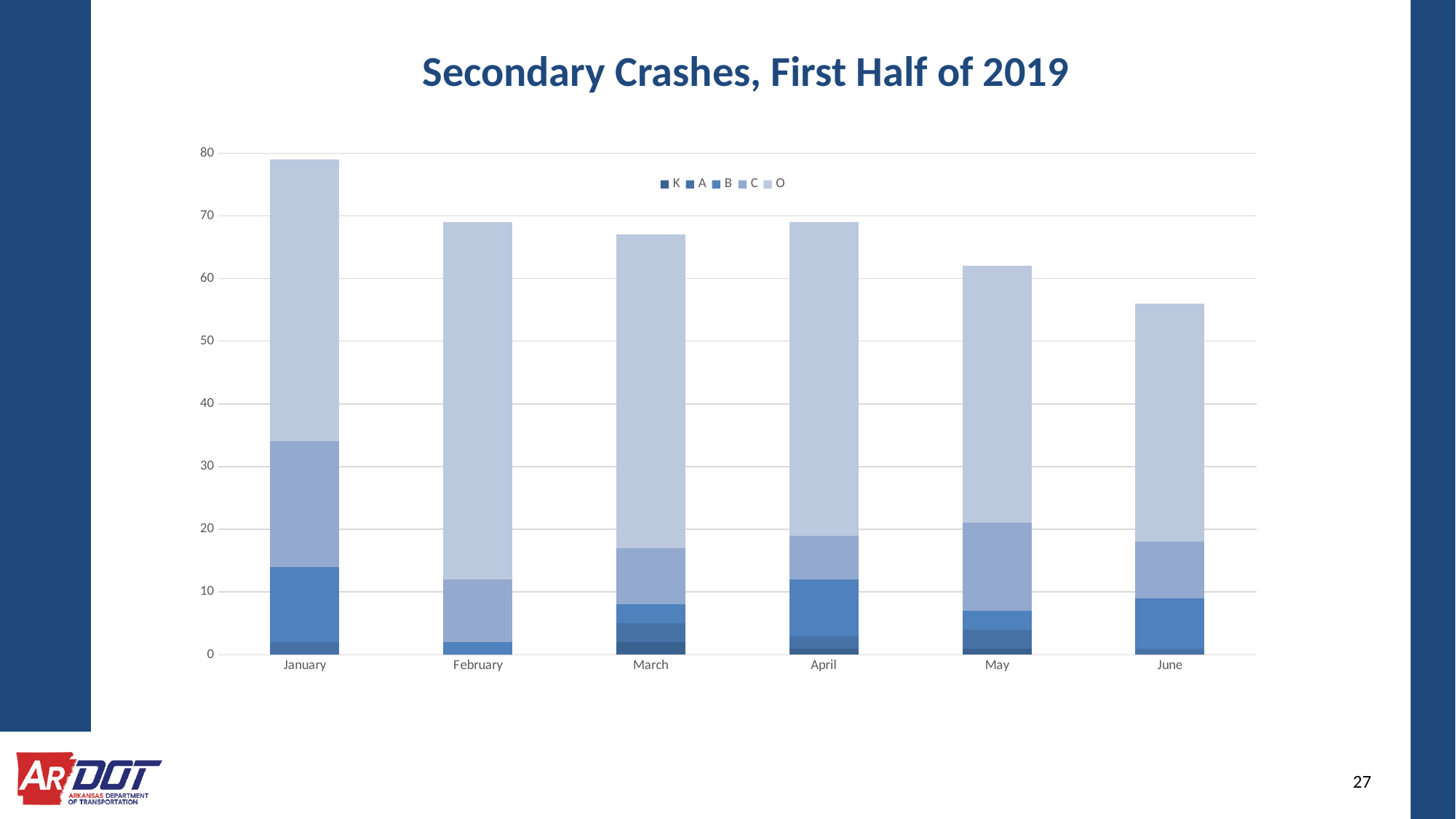
How many series does the legend list? 5 Overall, do the total bar heights rise or fall from January to June? fall How many months are shown on the x axis? 6 Is the total bar for June greater or less than 60? less What is the title of the chart? Secondary Crashes, First Half of 2019 Which month has the lowest total bar? June Which series are listed in the legend? K, A, B, C, O Is the total bar for March greater or less than 70? less Which month has a higher total bar, January or June? January What type of chart is shown on the slide? Stacked bar chart Is the total bar for January greater or less than 70? greater Which month has the highest total bar? January